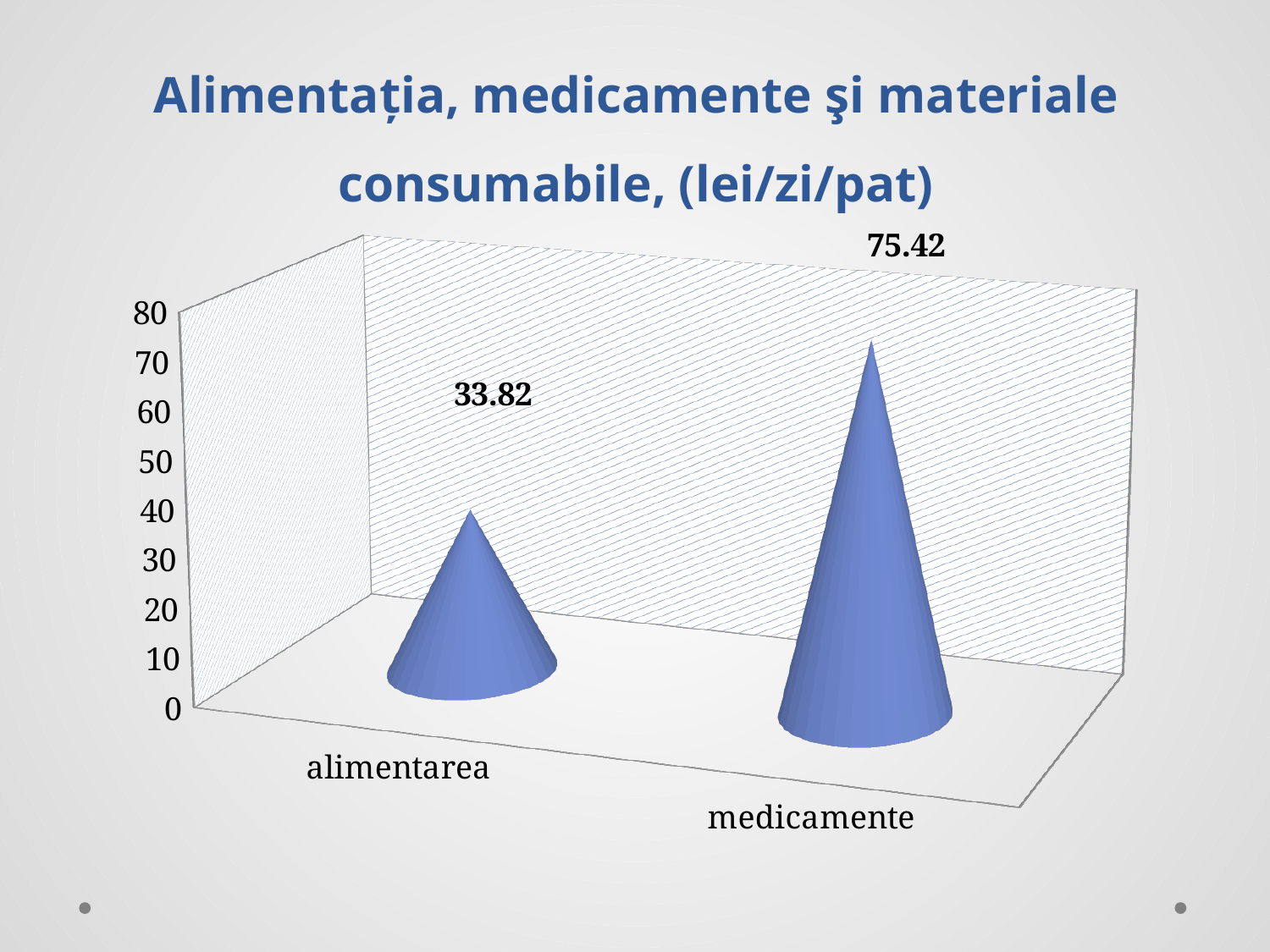
Is the value for alimentarea greater or less than 40? less How many categories are shown on the chart? 2 Which is larger, the value for alimentarea or the value for medicamente? medicamente Is the value for medicamente greater or less than 70? greater What kind of chart is shown on the slide? bar chart What unit is given in the chart title? lei/zi/pat What is the value for medicamente? 75.42 What is the difference between the values for medicamente and alimentarea? 41.6 What is the value for alimentarea? 33.82 Which category has the highest value? medicamente Which category has the lowest value? alimentarea What is the maximum value shown on the vertical axis? 80